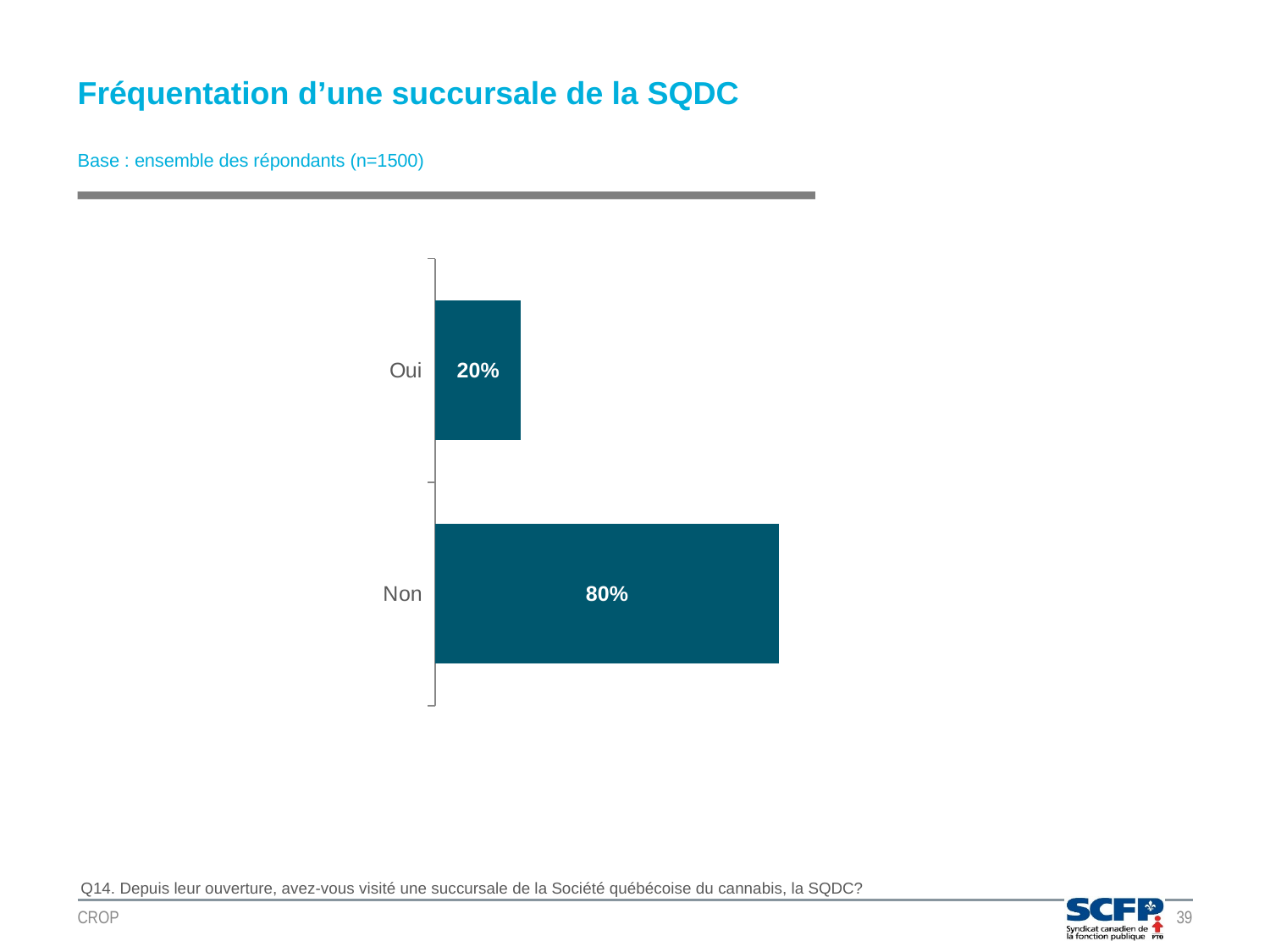
What is the difference between the values for Non and Oui? 60% What is the title of the slide containing the chart? Fréquentation d'une succursale de la SQDC Which category has the lowest value? Oui Which is larger, the value for Oui or the value for Non? Non What is the value for Non? 80% Which category has the highest value? Non What kind of chart is shown on the slide? Bar chart How many categories are shown in the chart? 2 What is the total of the values for Oui and Non? 100% What is the base (number of respondents) stated for the chart? n=1500 What is the value for Oui? 20%